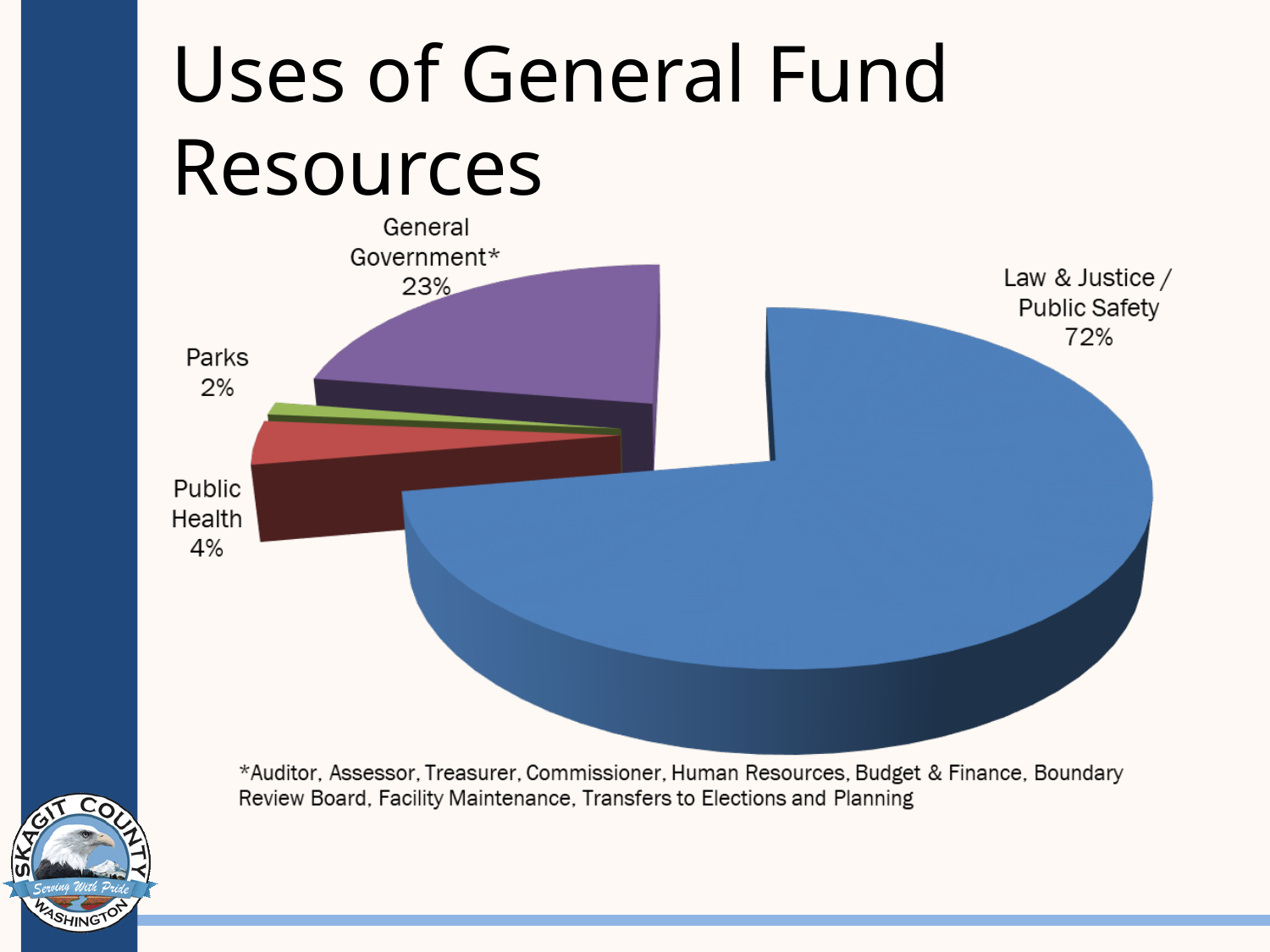
Which category has the smallest share of the pie? Parks How many categories are shown in the pie chart? 4 Which is larger, the share for Public Health or the share for Parks? Public Health What kind of chart is shown on the slide? Pie chart What share of General Fund resources goes to Law & Justice / Public Safety? 72% Which category has the largest share of the pie? Law & Justice / Public Safety What is the combined share of Public Health and Parks? 6% What percentage is shown for Parks? 2% What colour is the Law & Justice / Public Safety slice? Blue What is the difference in percentage points between Law & Justice / Public Safety and General Government*? 49 What percentage is shown for General Government*? 23% What percentage is shown for Public Health? 4%